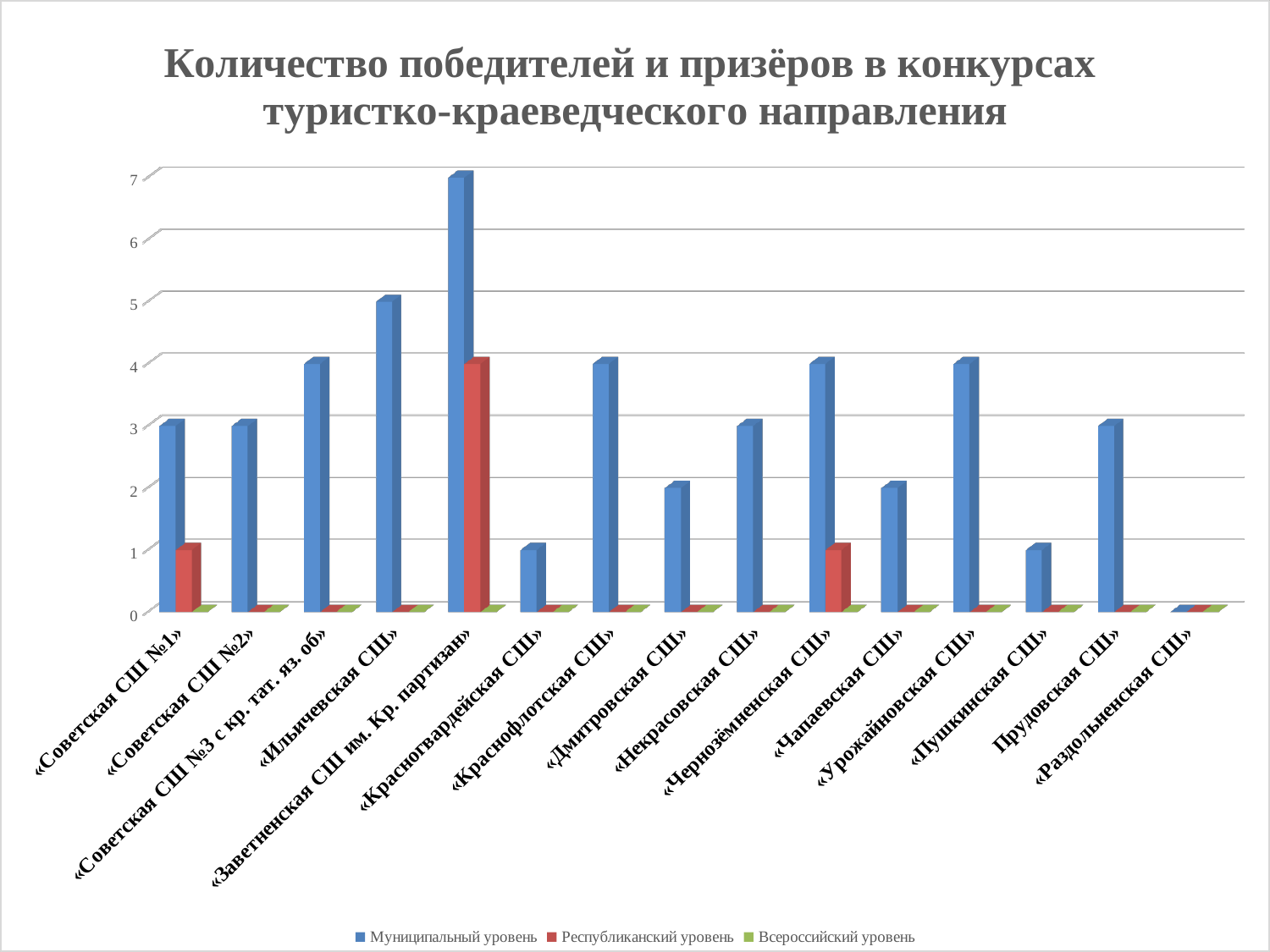
Which school has the highest value for Муниципальный уровень? «Заветненская СШ им. Кр. партизан» How many schools (categories) are shown on the x axis? 15 Is the value for Муниципальный уровень at «Заветненская СШ им. Кр. партизан» greater or less than 6? greater What is the value for Республиканский уровень at «Заветненская СШ им. Кр. партизан»? 4 Which school has the highest value for Республиканский уровень? «Заветненская СШ им. Кр. партизан» How many series does the legend list? 3 What colour represents Всероссийский уровень in the legend? green What type of chart is shown on the slide? bar chart What is the value for Муниципальный уровень at «Ильичевская СШ»? 5 What is the value for Муниципальный уровень at «Заветненская СШ им. Кр. партизан»? 7 Is the value for Муниципальный уровень at «Пушкинская СШ» greater or less than 2? less Which is larger for Муниципальный уровень: «Ильичевская СШ» or «Дмитровская СШ»? «Ильичевская СШ»